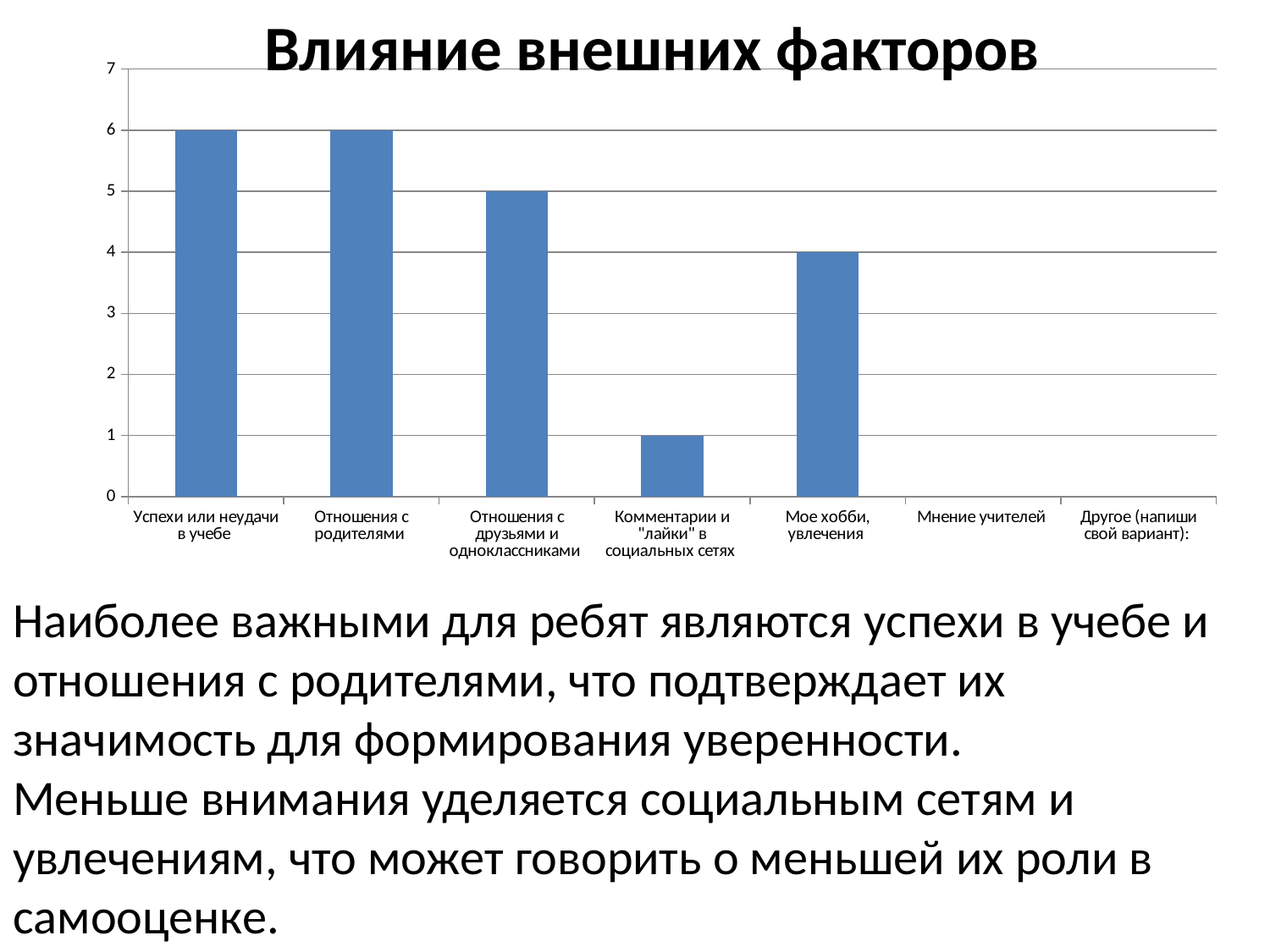
Is the value for "Комментарии и "лайки" в социальных сетях" greater or less than 2? less How many categories are shown on the x axis of the chart? 7 What is the value for "Комментарии и "лайки" в социальных сетях"? 1 Is the value for "Мое хобби, увлечения" greater or less than 3? greater What is the value for "Отношения с друзьями и одноклассниками"? 5 Which is larger: the value for "Мое хобби, увлечения" or the value for "Отношения с друзьями и одноклассниками"? Отношения с друзьями и одноклассниками What is the value for "Мое хобби, увлечения"? 4 What is the difference between the values for "Успехи или неудачи в учебе" and "Мое хобби, увлечения"? 2 What is the title of the chart? Влияние внешних факторов What kind of chart is shown on the slide? bar chart What is the value for "Успехи или неудачи в учебе"? 6 What is the difference between the values for "Отношения с родителями" and "Комментарии и "лайки" в социальных сетях"? 5